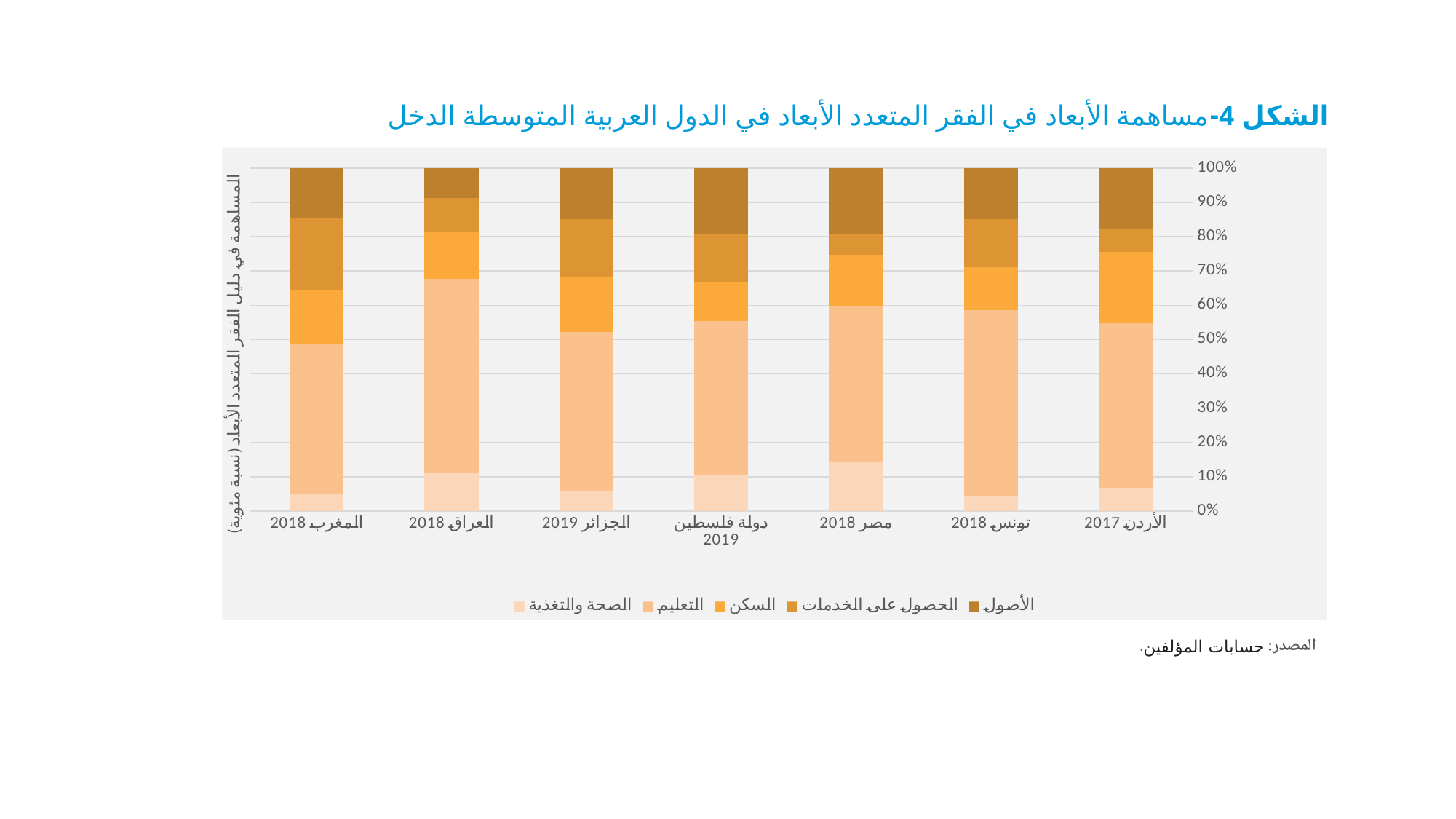
Is the value of الصحة والتغذية for تونس 2018 greater or less than 10%? less Which has the larger الصحة والتغذية value, مصر 2018 or تونس 2018? مصر 2018 Which category has the largest الصحة والتغذية segment? مصر 2018 What kind of chart is shown on the slide? Stacked bar chart Is the value of الصحة والتغذية for المغرب 2018 greater or less than 10%? less Which category has the smallest الأصول segment? العراق 2018 How many series does the legend list? 5 Is the value of الصحة والتغذية for مصر 2018 greater or less than 10%? greater Which series is shown at the bottom of each stacked bar? الصحة والتغذية What is the title of the chart? الشكل 4- مساهمة الأبعاد في الفقر المتعدد الأبعاد في الدول العربية المتوسطة الدخل What is the total of the stacked bar for المغرب 2018? 100% How many country-year categories are shown on the x axis? 7